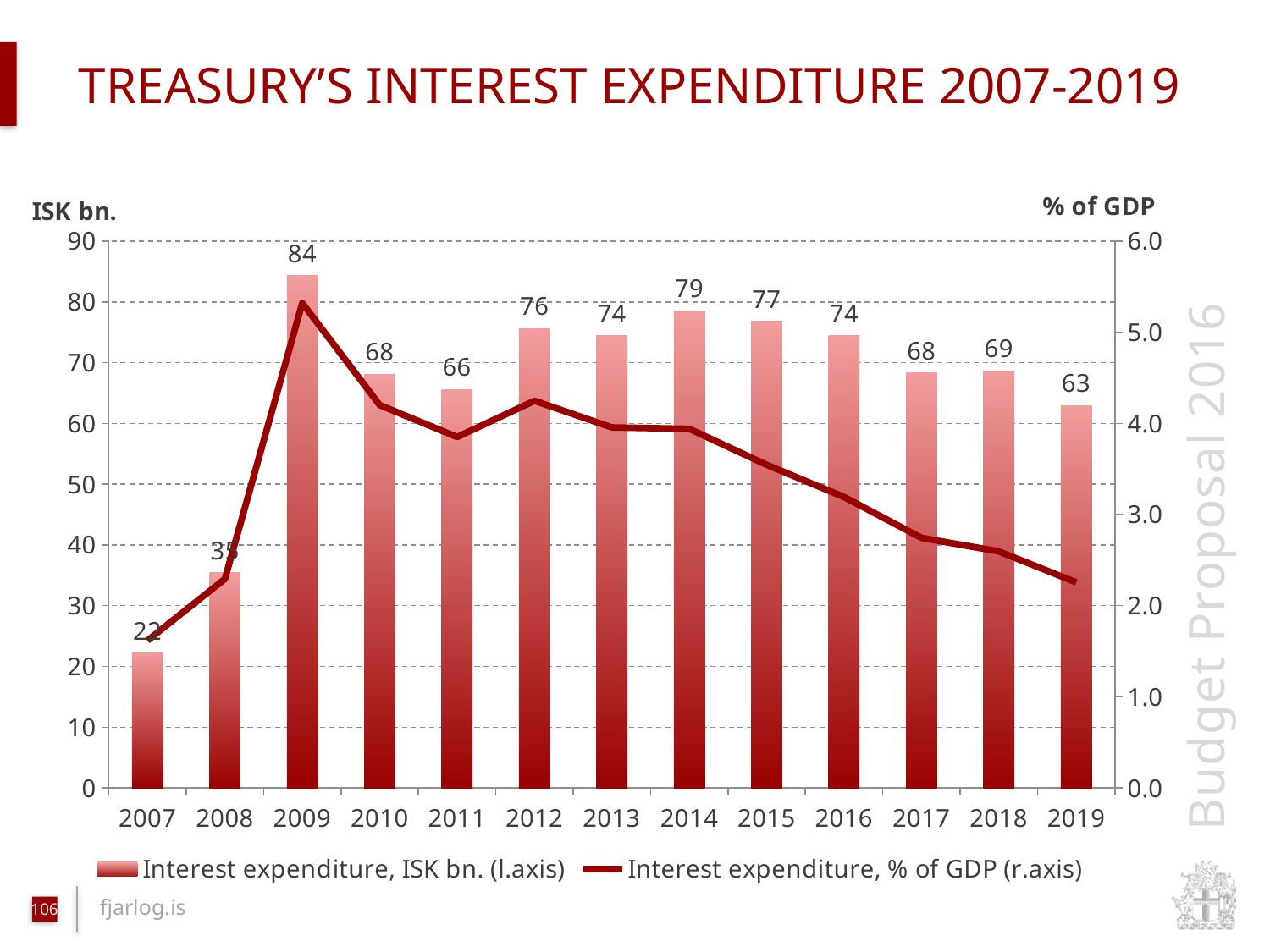
How many series does the chart legend list? 2 Is the interest expenditure as % of GDP for 2019 greater or less than 3.0? less Which year has the lowest interest expenditure in ISK bn.? 2007 What is the interest expenditure in ISK bn. for 2007? 22 What is the difference in interest expenditure (ISK bn.) between 2009 and 2007? 62 Which year has the highest interest expenditure in ISK bn.? 2009 Is the interest expenditure as % of GDP for 2009 greater or less than 5.0? greater Which year has the larger interest expenditure in ISK bn., 2014 or 2016? 2014 How many years are shown on the x axis of the chart? 13 What is the Treasury's interest expenditure in ISK bn. for 2009? 84 By how much does the interest expenditure in ISK bn. for 2014 exceed that for 2019? 16 What is the interest expenditure in ISK bn. shown for 2019? 63